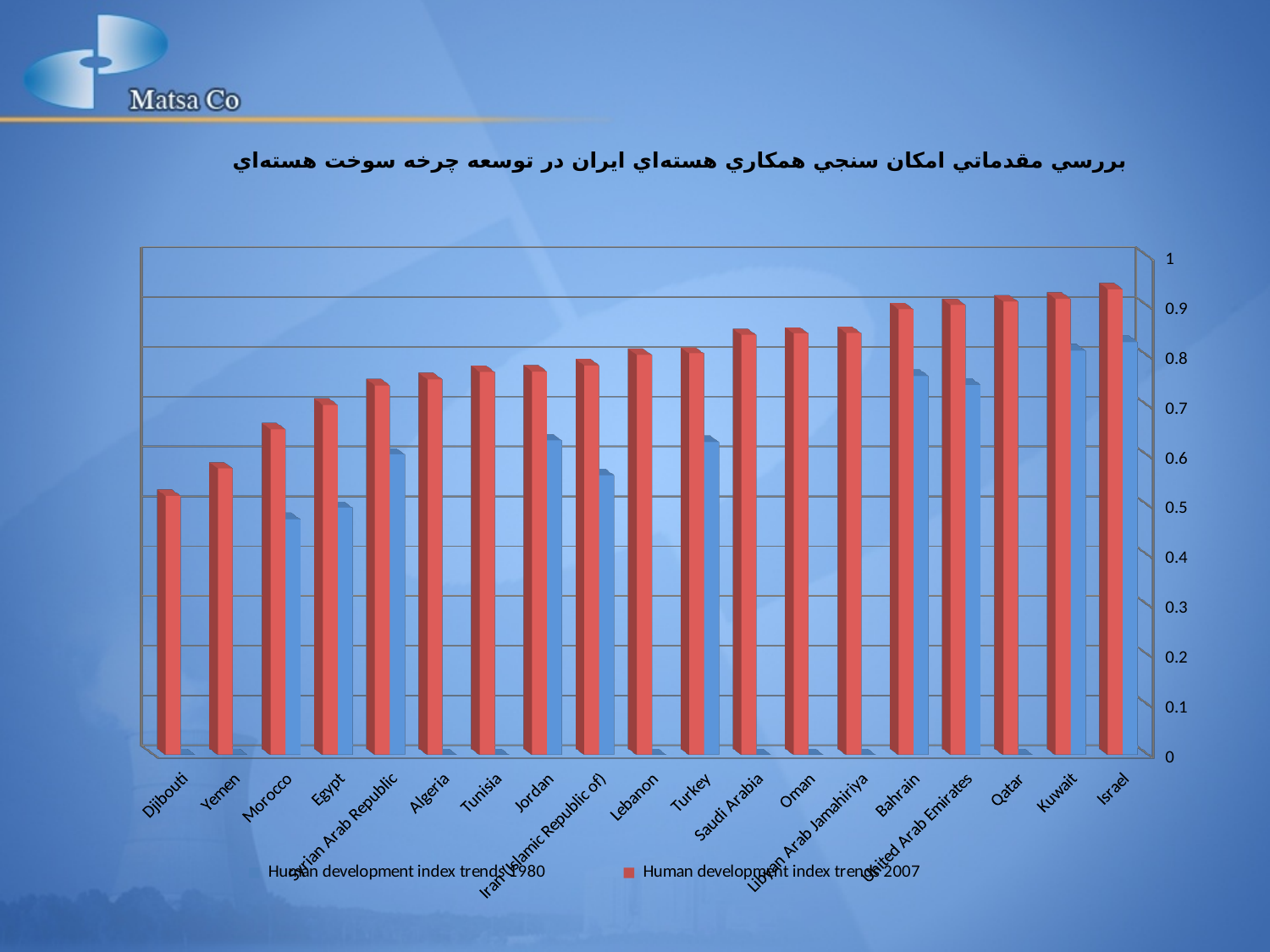
Is the Human development index trends 1980 value for Bahrain greater or less than 0.7? greater Is the Human development index trends 2007 value for Djibouti greater or less than 0.6? less Is the Human development index trends 2007 value for Egypt greater or less than 0.6? greater How many countries are shown on the x axis of the chart? 19 How many series does the legend list? 2 Which colour represents the Human development index trends 2007 series? red Which country has the lowest value for Human development index trends 2007? Djibouti Which has the larger Human development index trends 1980 value, Jordan or Iran (Islamic Republic of)? Jordan Do the Human development index trends 2007 values rise or fall moving from Djibouti to Israel along the x axis? rise What kind of chart is shown on the slide? bar chart